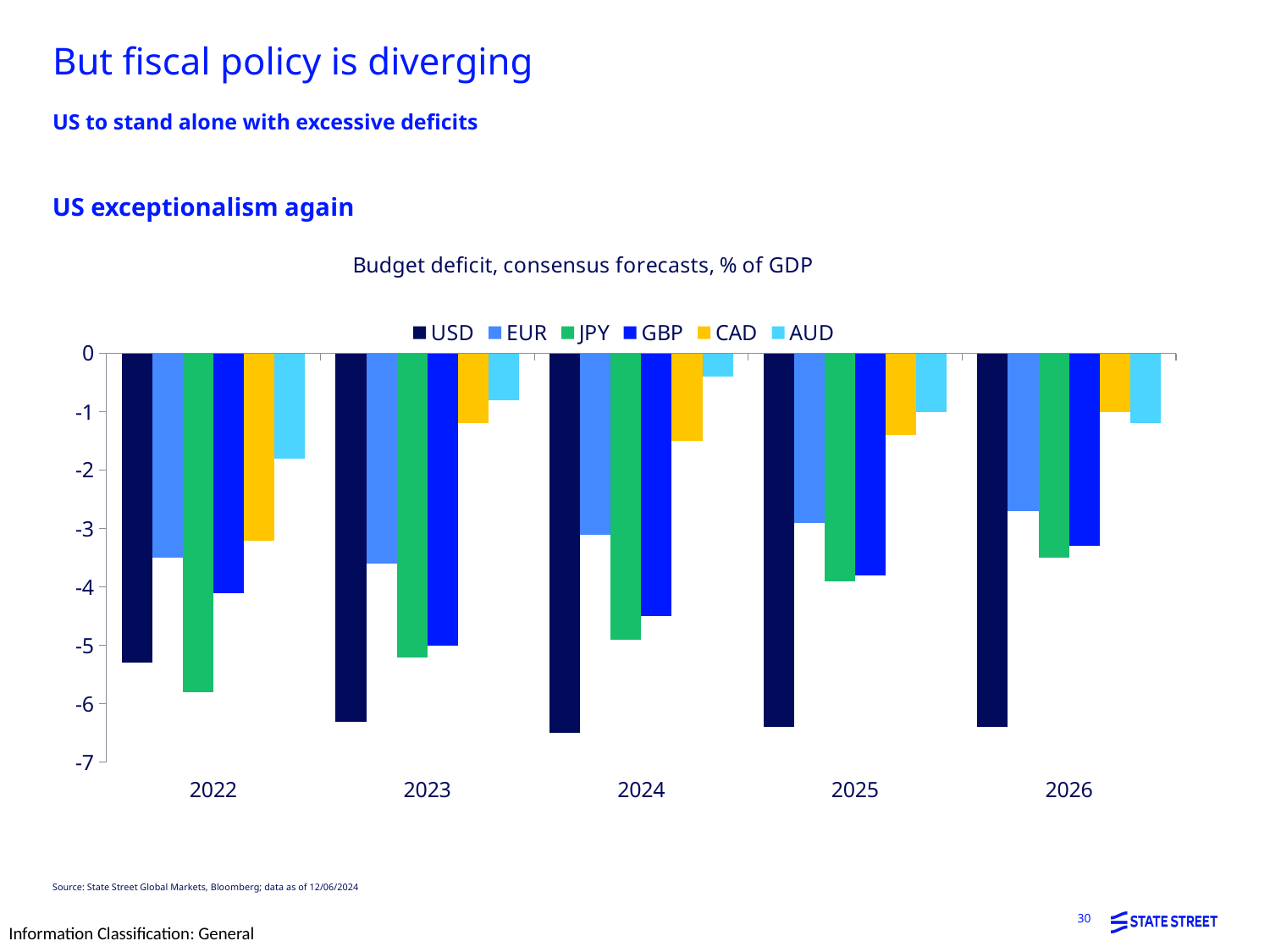
Is the value for CAD in 2022 greater or less than -4? greater What kind of chart is shown on the slide? Bar chart Do the EUR bars get shorter or longer from 2023 to 2026? Shorter How many series does the legend list? 6 Is the value for USD in 2023 greater or less than -6? less Is the value for EUR in 2026 greater or less than -3? greater Which series has the longest bar in 2022? JPY How many years are shown on the x axis? 5 Which series has the shortest bar (smallest deficit) in 2022? AUD Which series has the deepest (longest) bar in 2024? USD In 2022, which shows a larger deficit (longer bar): USD or GBP? USD What is the title of the chart? Budget deficit, consensus forecasts, % of GDP